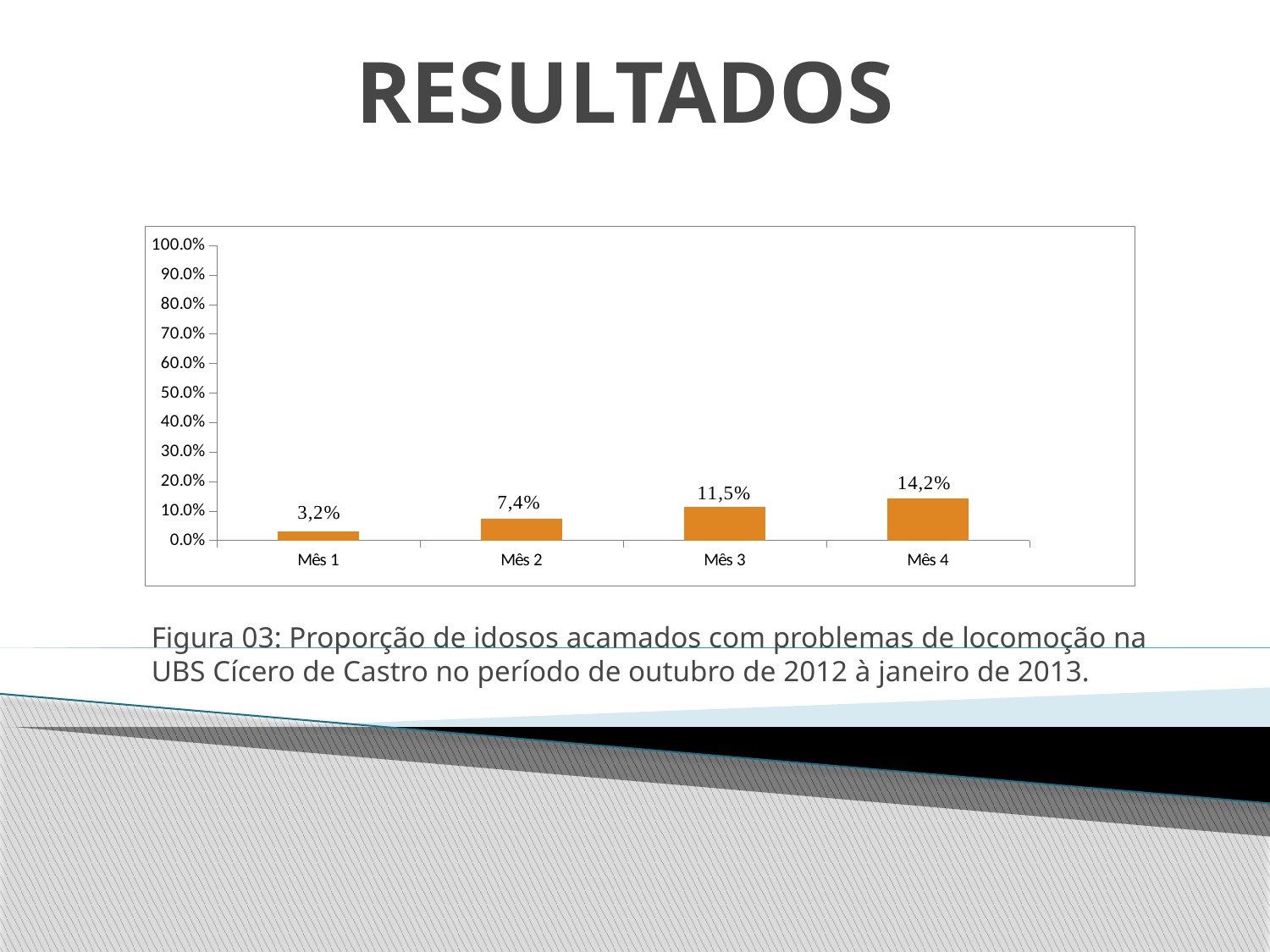
How many months are shown on the x axis? 4 Which month has the lowest value? Mês 1 What kind of chart is shown on the slide? bar chart Do the values rise or fall from Mês 1 to Mês 4? rise What is the value for Mês 1? 3,2% What is the value for Mês 3? 11,5% What is the difference between the values for Mês 3 and Mês 2? 4,1% What is the value for Mês 4? 14,2% Which month has the highest value? Mês 4 What is the difference between the values for Mês 4 and Mês 1? 11,0% Is the value for Mês 4 greater or less than 20.0%? less Which is larger, the value for Mês 2 or the value for Mês 3? Mês 3